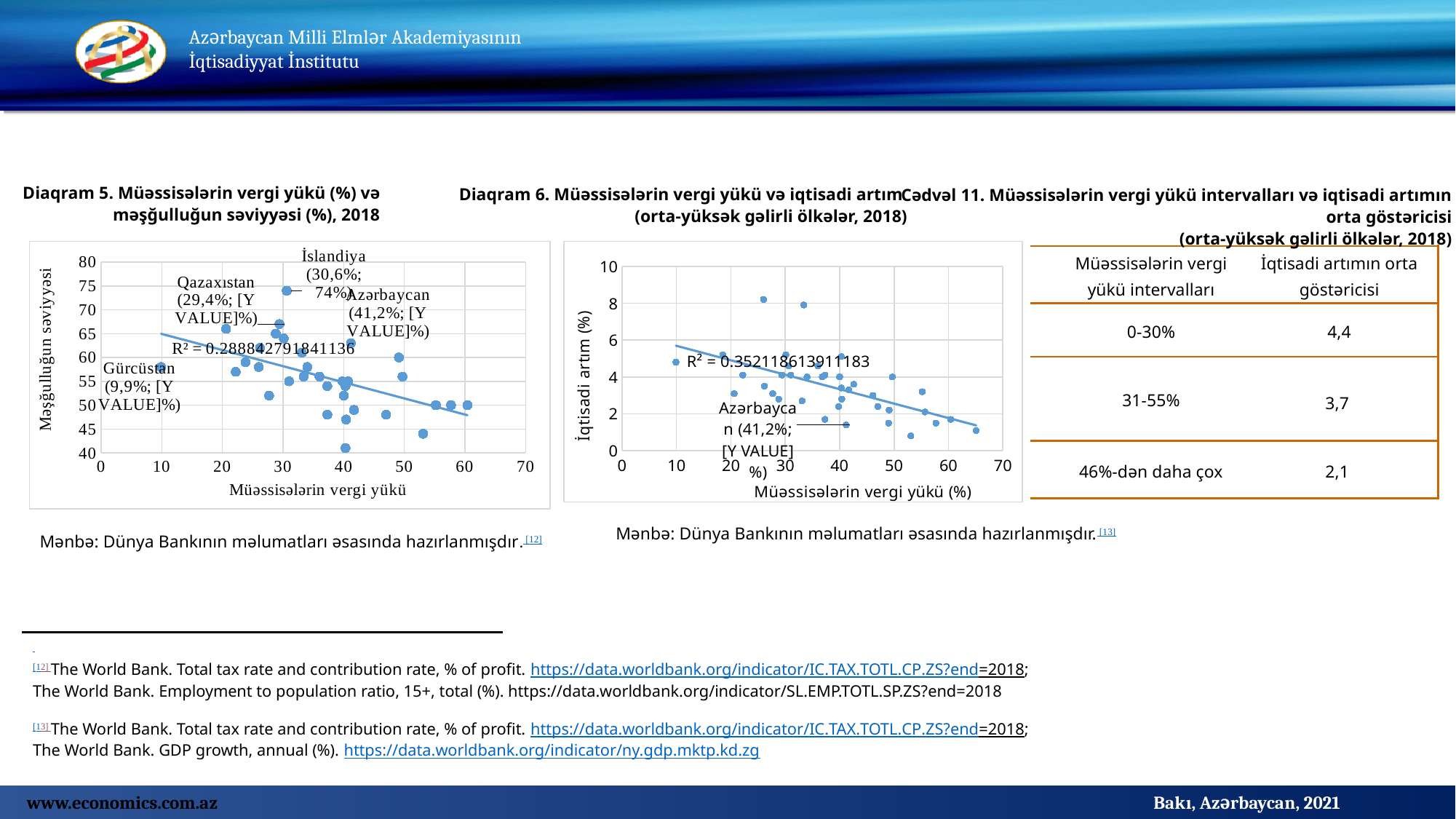
What is the y-axis label of Diaqram 6? İqtisadi artım (%) What kind of chart is Diaqram 6? scatter chart In Diaqram 5, what is the tax burden labelled for Gürcüstan? 9,9% In Diaqram 6, does the fitted trend line rise or fall as the tax burden increases? falls In Diaqram 5, what employment level (y value) is labelled for İslandiya? 74% In Diaqram 5, what is the difference between the labelled tax burden of Azərbaycan and that of Gürcüstan? 31,3 percentage points In Diaqram 5, what R² value is printed on the chart? 0.288842791841136 What kind of chart is Diaqram 5? scatter chart In Diaqram 5, which has the higher labelled tax burden, İslandiya or Azərbaycan? Azərbaycan In Diaqram 6, what R² value is printed on the chart? 0.352118613911183 In Diaqram 5, what is the tax burden labelled for Qazaxıstan? 29,4% In Diaqram 5, what is the tax burden (x value) labelled for İslandiya? 30,6%